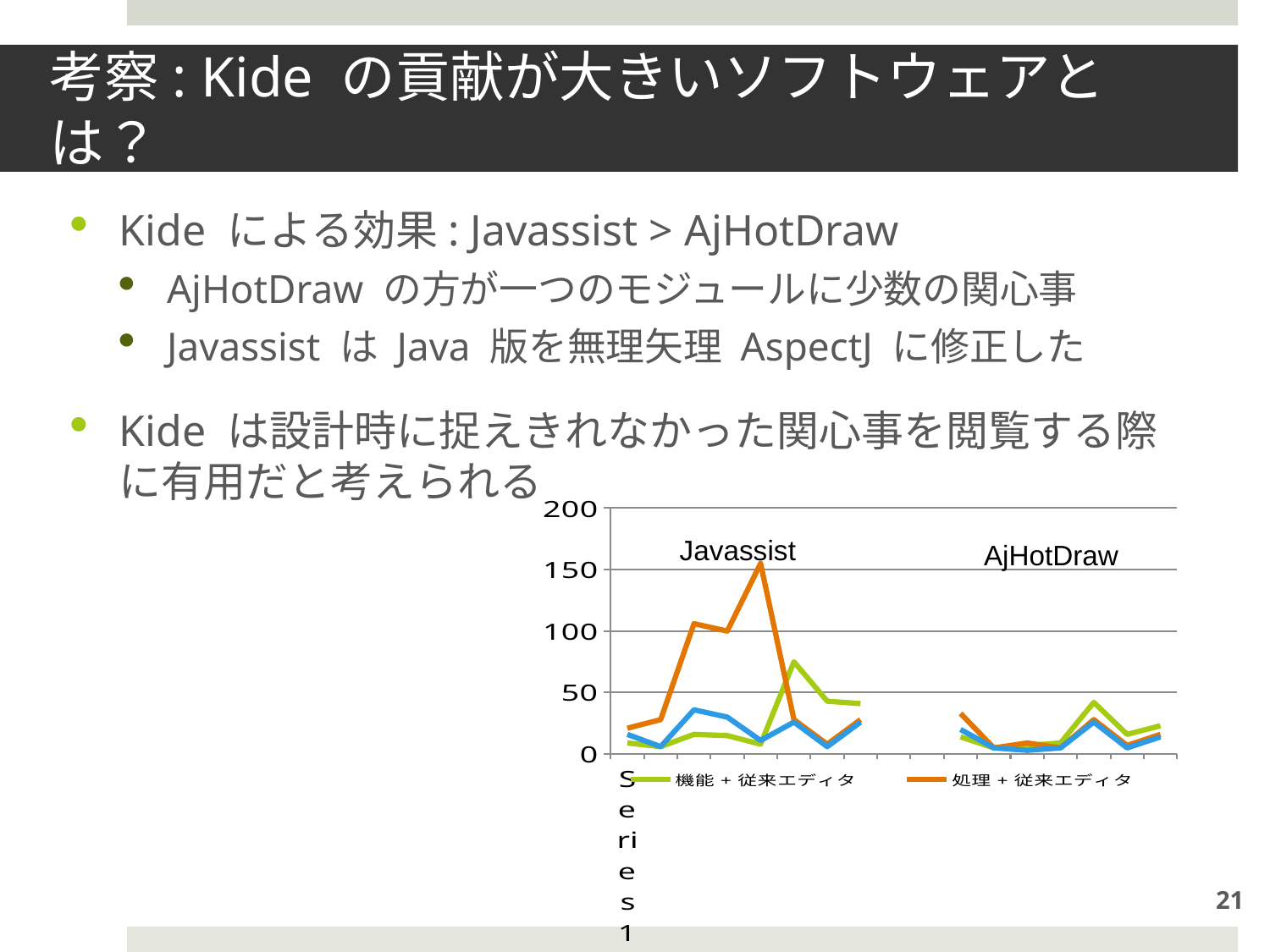
Is the peak value of the 機能 + 従来エディタ line in the Javassist section greater or less than 100? less Is the peak value of the 処理 + 従来エディタ line in the AjHotDraw section greater or less than 100? less Is the peak value of the 処理 + 従来エディタ line in the Javassist section greater or less than 100? greater Which two software names are labelled on the chart? Javassist and AjHotDraw What is the highest value shown on the chart's vertical axis? 200 In the Javassist section, which series reaches the higher peak, 機能 + 従来エディタ or 処理 + 従来エディタ? 処理 + 従来エディタ How many series does the chart's legend list? 3 Which section of the chart reaches the higher peak value, Javassist or AjHotDraw? Javassist What kind of chart is shown on the slide? line chart